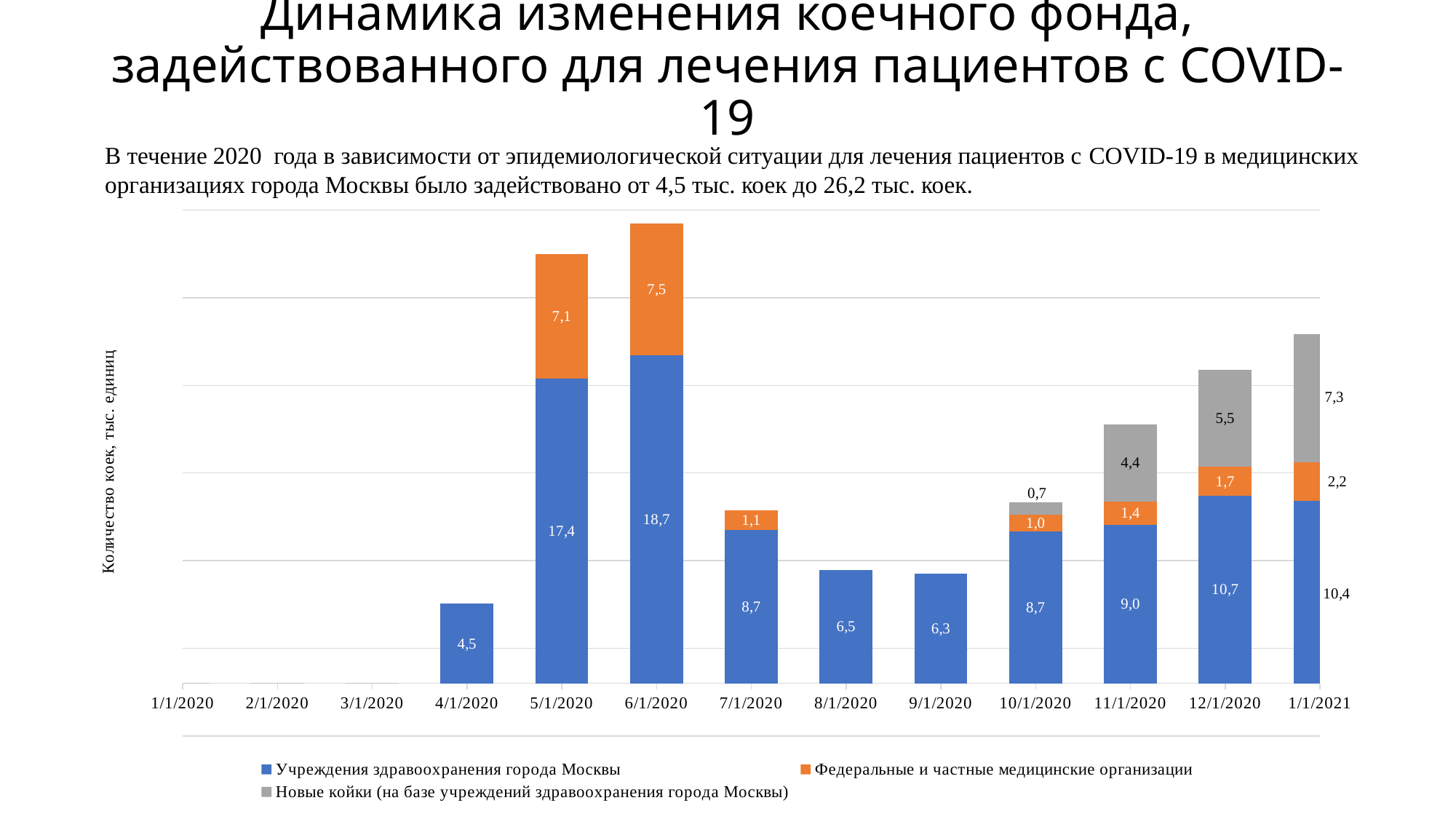
What kind of chart is shown on the slide? bar chart What is the total of the stacked bar for 6/1/2020? 26,2 How many series does the legend list? 3 What is the value for Учреждения здравоохранения города Москвы on 6/1/2020? 18,7 What is the total of the stacked bar for 12/1/2020? 17,9 On which date is the value for Учреждения здравоохранения города Москвы the highest? 6/1/2020 What is the difference between the Учреждения здравоохранения города Москвы values on 6/1/2020 and 5/1/2020? 1,3 What is the label of the vertical axis? Количество коек, тыс. единиц Which is larger: the Новые койки value on 12/1/2020 or on 11/1/2020? 12/1/2020 What is the value for Новые койки (на базе учреждений здравоохранения города Москвы) on 1/1/2021? 7,3 On which date is the value for Учреждения здравоохранения города Москвы the lowest? 4/1/2020 What is the value for Федеральные и частные медицинские организации on 5/1/2020? 7,1